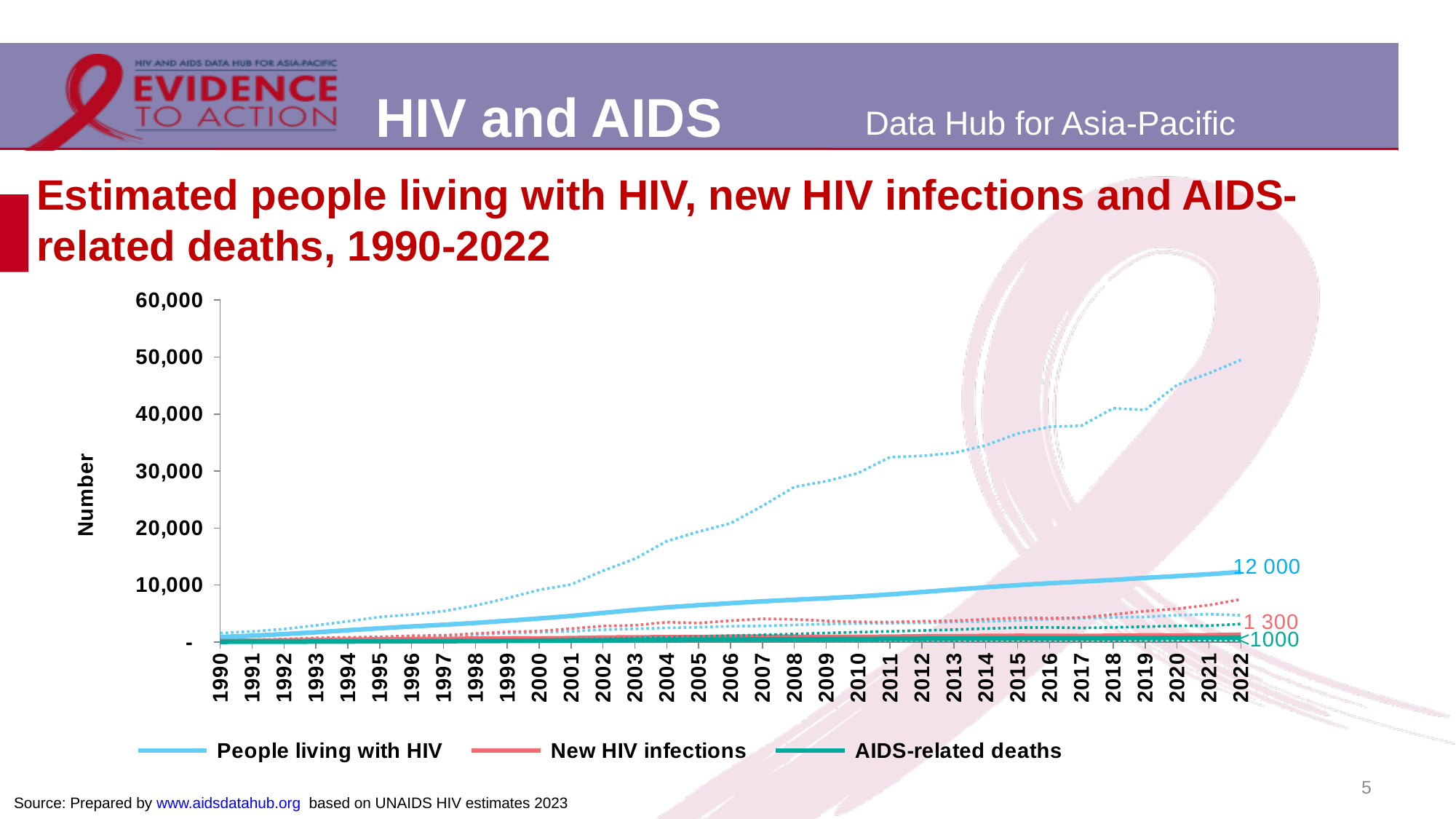
What is the estimated number of people living with HIV in 2022? 12 000 Which is larger in 2022, the number of people living with HIV or the number of new HIV infections? People living with HIV What kind of chart is shown on the slide? line chart Is the value for people living with HIV in 2022 greater or less than 10,000? greater How many series does the legend list? 3 What is the label of the y axis? Number How many years are shown on the x axis? 33 Which series has the lowest value in 2022? AIDS-related deaths Does the number of people living with HIV rise or fall from 1990 to 2022? rise What is the estimated number of AIDS-related deaths in 2022? <1000 What is the estimated number of new HIV infections in 2022? 1 300 Which series has the highest value in 2022? People living with HIV